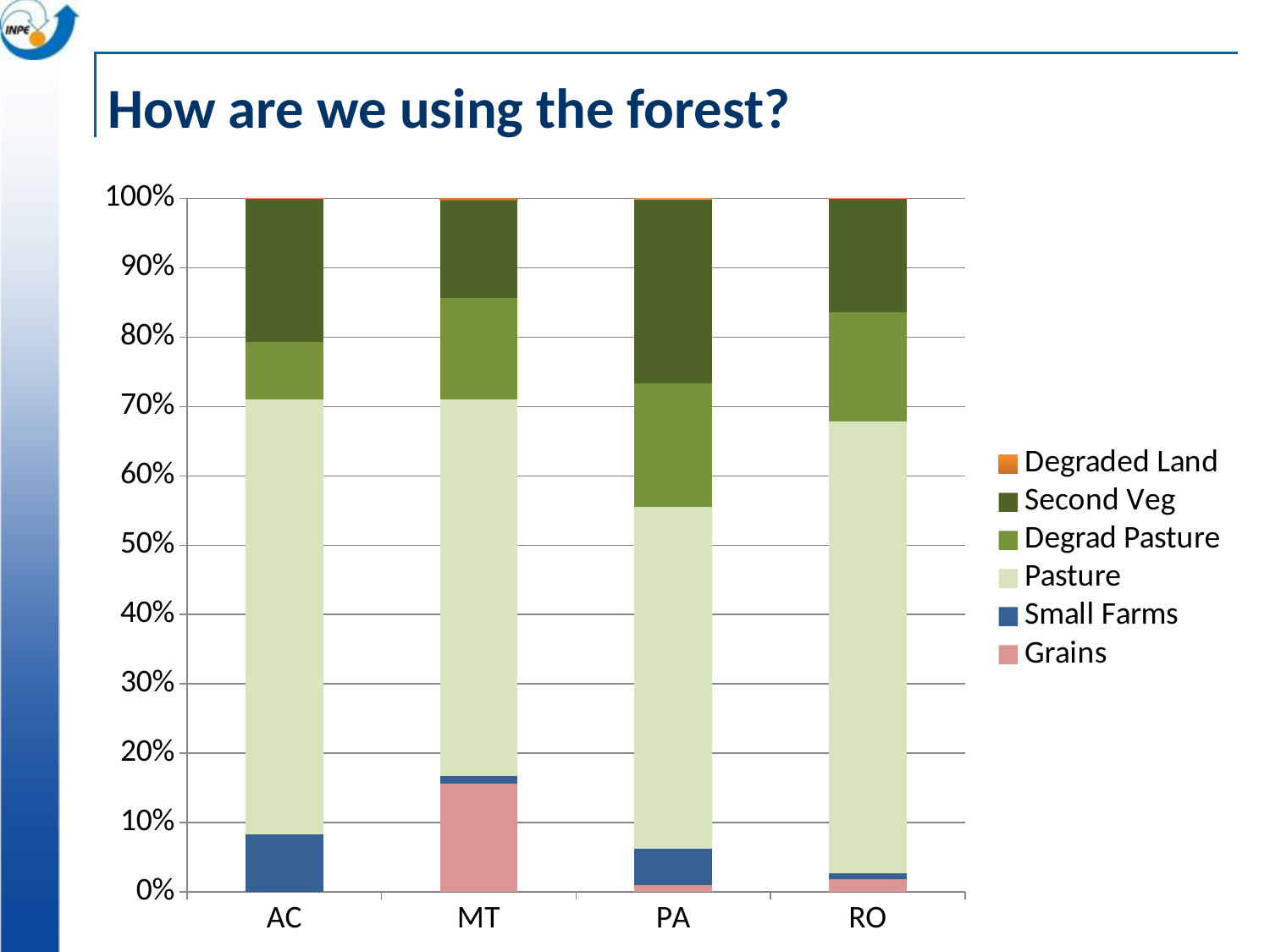
Which category has the largest Grains segment? MT Is the Small Farms segment for AC greater or less than 10%? less Which category has the largest Small Farms segment? AC How many categories are shown on the x axis of the chart? 4 What kind of chart is shown on the slide? Stacked bar chart Which legend entry is shown in orange? Degraded Land What is the title of the slide containing the chart? How are we using the forest? How many series does the chart's legend list? 6 What does each stacked bar in the chart total? 100% Which has the larger Degrad Pasture segment, PA or AC? PA Which category has the largest Second Veg segment? PA Is the Grains segment for MT greater or less than 10%? greater